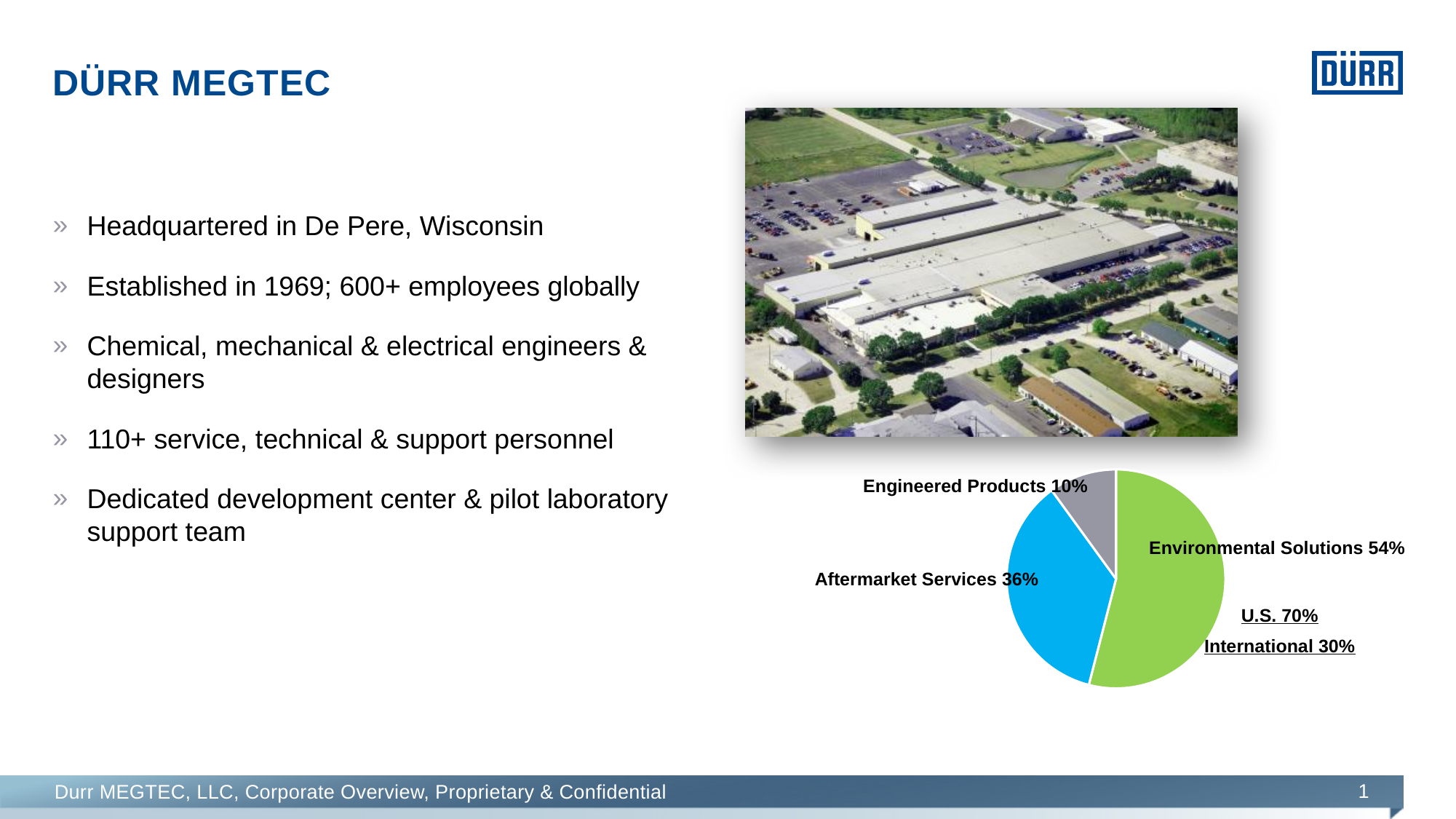
What colour is the Aftermarket Services slice of the pie chart? blue What kind of chart is shown on the slide? pie chart What share of the pie chart is Environmental Solutions? 54% What is the difference in percentage points between Aftermarket Services and Engineered Products in the pie chart? 26 Which is larger in the pie chart, Aftermarket Services or Engineered Products? Aftermarket Services Which slice of the pie chart is the smallest? Engineered Products Which slice of the pie chart is the largest? Environmental Solutions What share of the pie chart is Engineered Products? 10% What is the difference in percentage points between Environmental Solutions and Aftermarket Services in the pie chart? 18 What share of the pie chart is Aftermarket Services? 36% How many slices does the pie chart have? 3 What colour is the Environmental Solutions slice of the pie chart? green